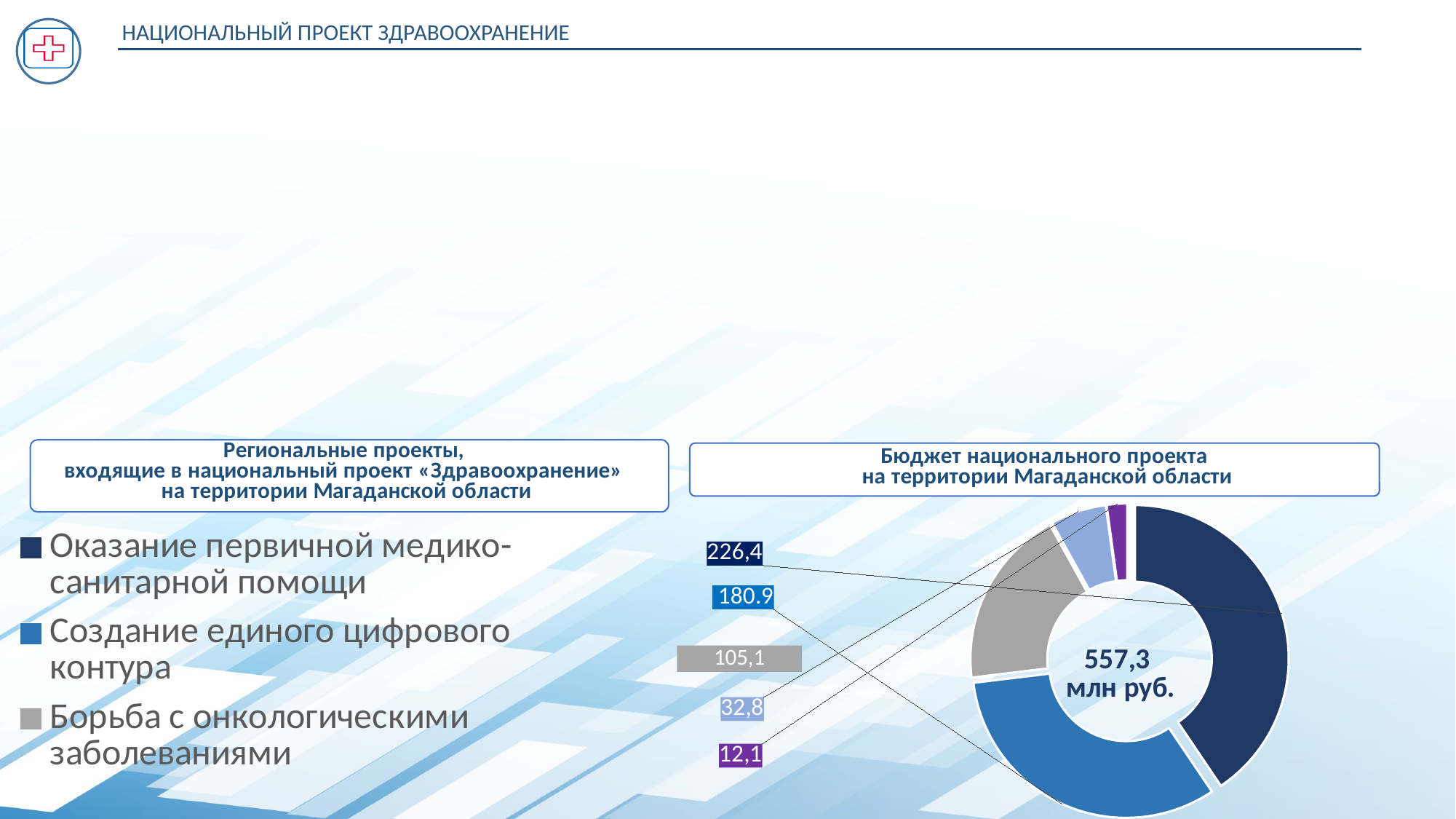
How many entries does the legend on the left list? 3 Which is larger: the value for «Создание единого цифрового контура» or for «Борьба с онкологическими заболеваниями»? Создание единого цифрового контура Which regional project has the largest share of the budget in the doughnut chart? Оказание первичной медико-санитарной помощи How many slices does the budget doughnut chart have? 5 What is the smallest value labelled on the budget doughnut chart? 12,1 What kind of chart is used to show the budget of the national project? Doughnut (pie) chart What is the title of the chart on the right side of the slide? Бюджет национального проекта на территории Магаданской области What total is shown in the centre of the doughnut chart? 557,3 млн руб. What is the difference between the values for «Оказание первичной медико-санитарной помощи» and «Создание единого цифрового контура»? 45,5 What is the value for «Создание единого цифрового контура» in the budget doughnut chart? 180.9 What is the value for «Оказание первичной медико-санитарной помощи» in the budget doughnut chart? 226,4 What is the value for «Борьба с онкологическими заболеваниями» in the budget doughnut chart? 105,1